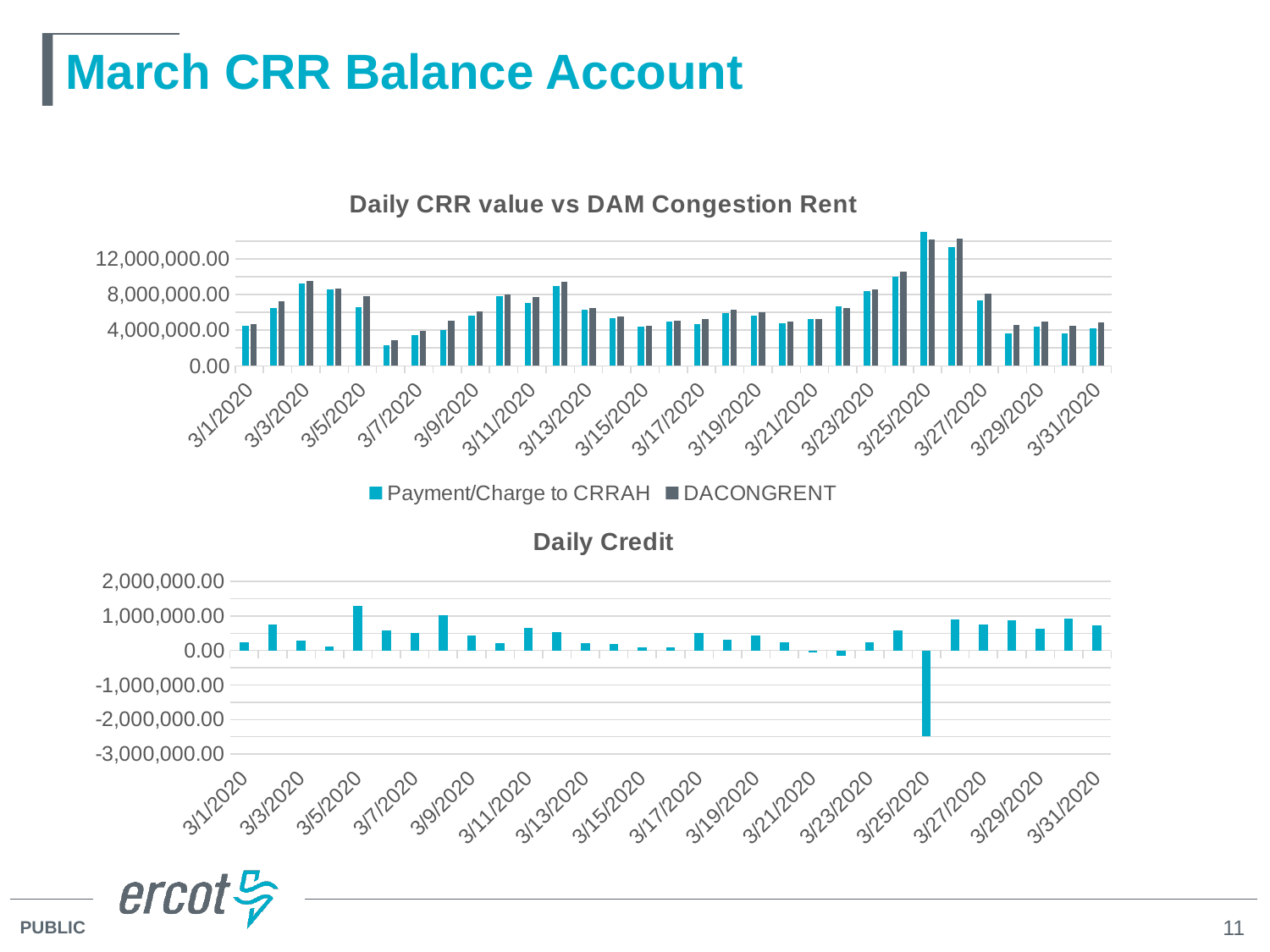
In the "Daily CRR value vs DAM Congestion Rent" chart, is the DACONGRENT value on 3/3/2020 greater or less than 8,000,000.00? greater In the "Daily CRR value vs DAM Congestion Rent" chart, is the Payment/Charge to CRRAH value on 3/25/2020 greater or less than 12,000,000.00? greater How many series does the legend of the "Daily CRR value vs DAM Congestion Rent" chart list? 2 In the "Daily CRR value vs DAM Congestion Rent" chart, what are the two series named in the legend? Payment/Charge to CRRAH and DACONGRENT In the "Daily Credit" chart, which date has the larger value, 3/5/2020 or 3/9/2020? 3/5/2020 What kind of chart is the "Daily Credit" chart? Bar chart What kind of chart is the "Daily CRR value vs DAM Congestion Rent" chart? Bar chart In the "Daily CRR value vs DAM Congestion Rent" chart, on which date is the Payment/Charge to CRRAH value highest? 3/25/2020 In the "Daily Credit" chart, on which date is the value highest? 3/5/2020 In the "Daily Credit" chart, on which date is the value lowest? 3/25/2020 In the "Daily Credit" chart, is the value on 3/25/2020 greater or less than -2,000,000.00? less